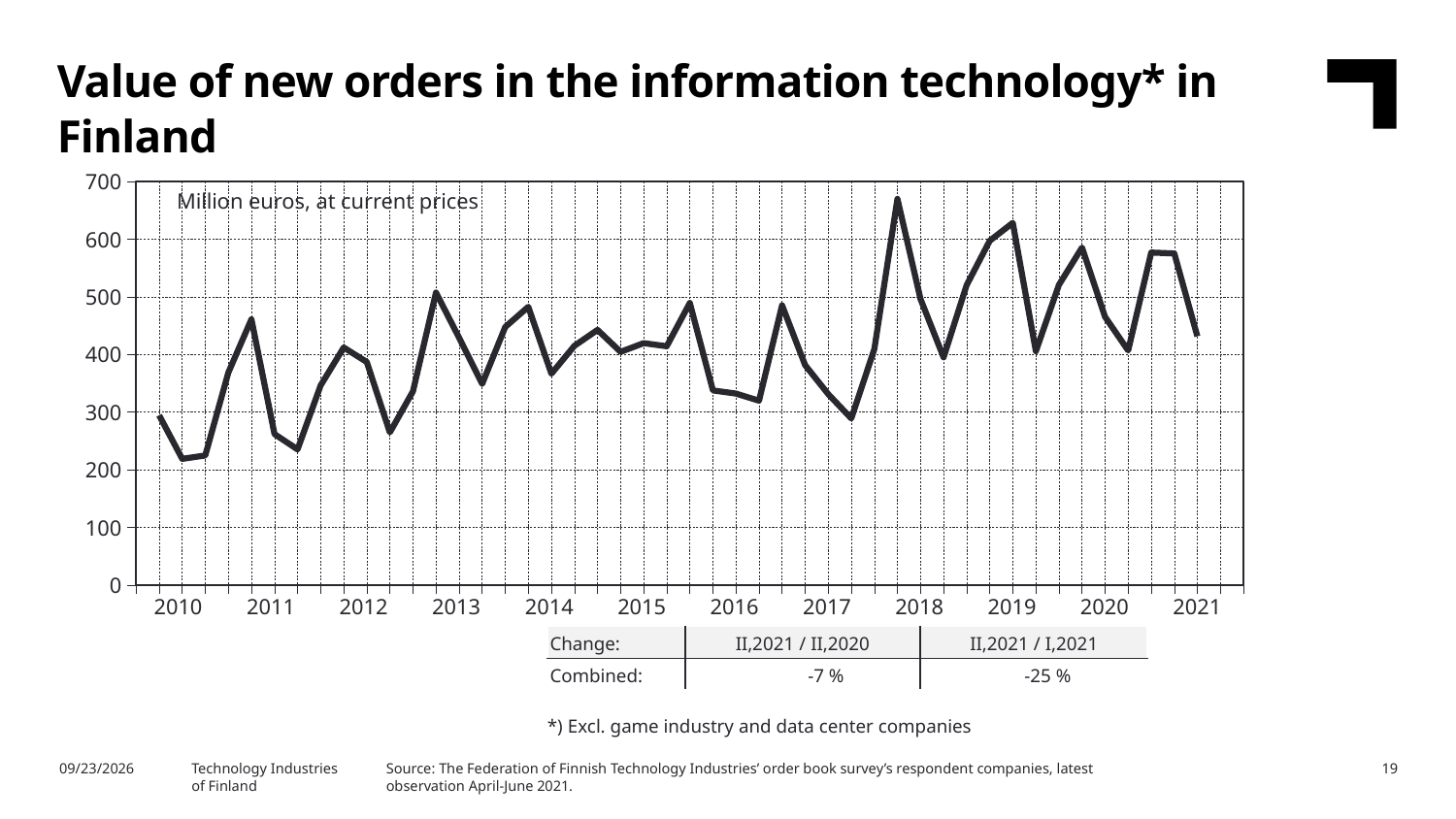
In which year does the line reach its highest point? 2018 How many lines are plotted on the chart? 1 In what unit are the values on the chart expressed, according to the label inside the plot area? Million euros, at current prices What is the title of the chart? Value of new orders in the information technology* in Finland How many years are labelled on the x axis? 12 Is the lowest point of the line greater or less than 300? less What kind of chart is shown on the slide? line chart Does the line rise or fall between its last two plotted points? fall According to the table below the chart, what is the combined change for II,2021 / I,2021? -25 % Is the highest point of the line greater or less than 600? greater In which year does the line reach its lowest point? 2010 Is the last plotted value, in 2021, greater or less than 400? greater